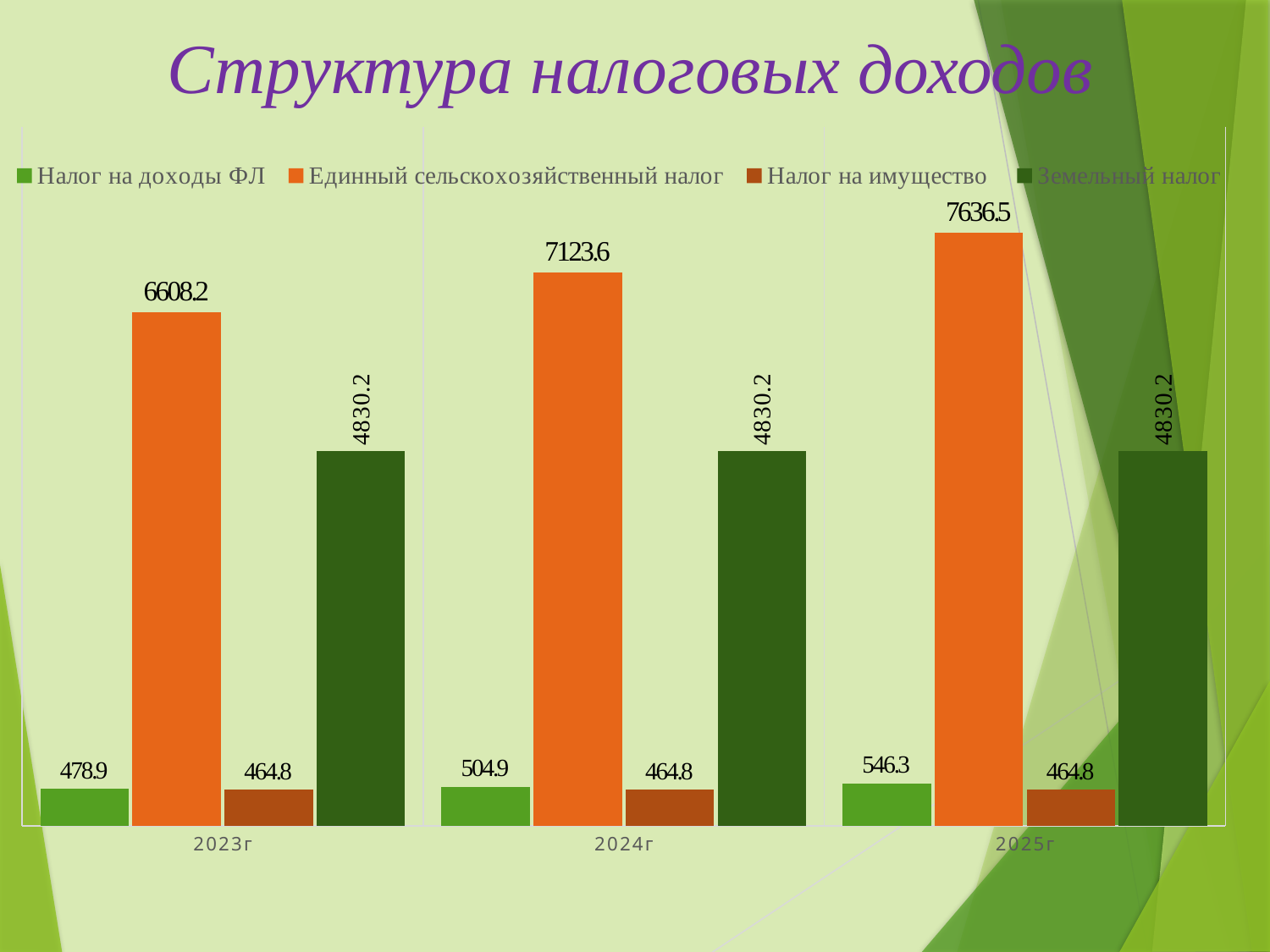
What is the value of Единный сельскохозяйственный налог for 2024г? 7123.6 What is the value of Земельный налог for 2023г? 4830.2 In which year is Единный сельскохозяйственный налог highest? 2025г What is the value of Налог на имущество for 2024г? 464.8 Does Налог на доходы ФЛ rise or fall from 2023г to 2025г? Rise In which year is Налог на доходы ФЛ lowest? 2023г How many series does the legend list? 4 What is the difference between Единный сельскохозяйственный налог in 2025г and in 2023г? 1028.3 What is the value of Налог на доходы ФЛ for 2025г? 546.3 Which is larger in 2023г: Налог на доходы ФЛ or Налог на имущество? Налог на доходы ФЛ What kind of chart is shown on the slide? Bar chart How many years are shown on the x axis? 3